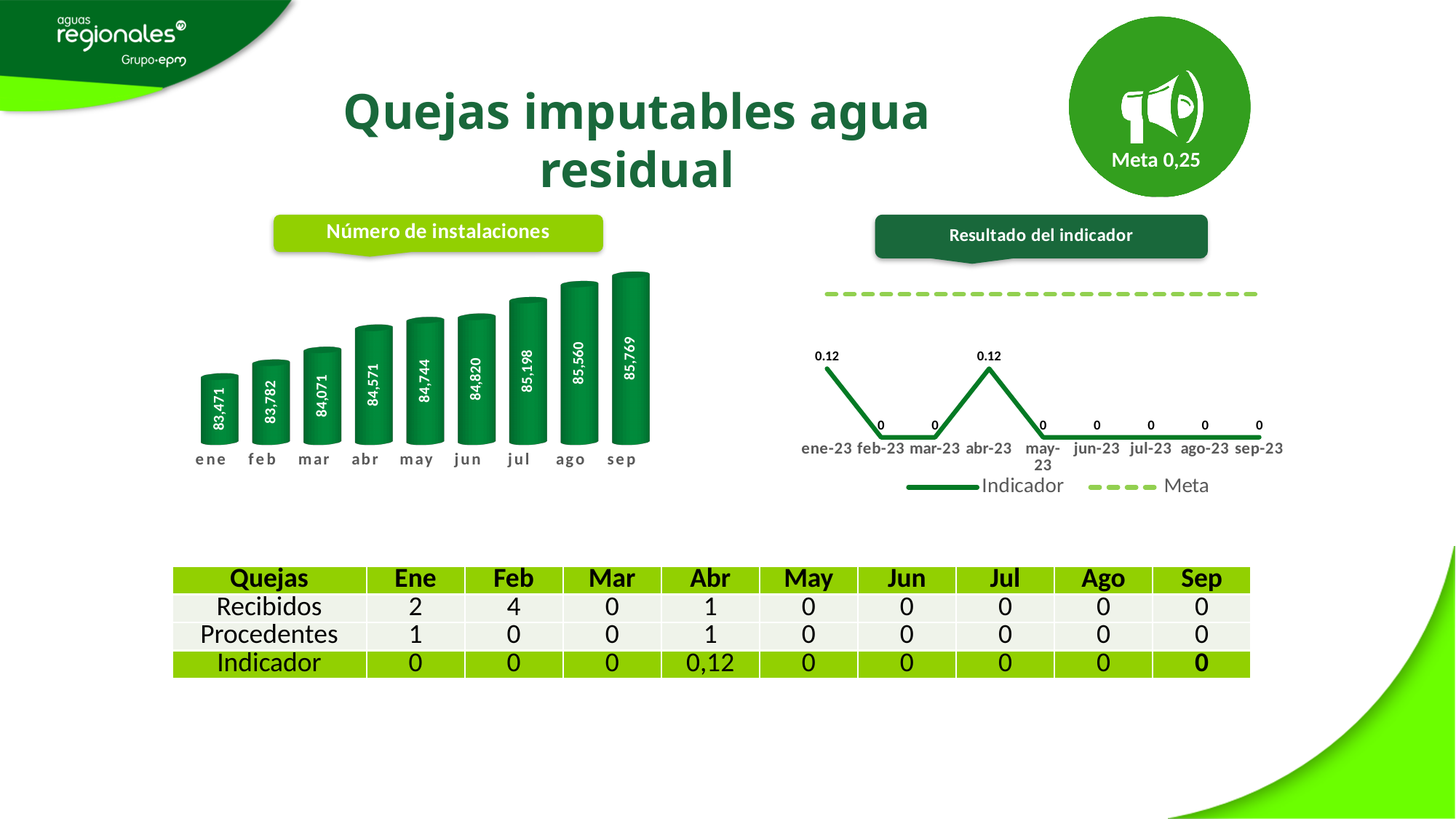
In the 'Número de instalaciones' chart, what is the value for sep? 85,769 In the 'Número de instalaciones' chart, which month has the lowest value? ene In the 'Número de instalaciones' chart, what is the value for abr? 84,571 In the 'Resultado del indicador' chart, what is the Indicador value for jun-23? 0 In the 'Número de instalaciones' chart, do the values rise or fall from ene to sep? rise What kind of chart is the 'Número de instalaciones' chart? bar chart In the 'Número de instalaciones' chart, which month has the highest value? sep In the 'Resultado del indicador' chart, how many series does the legend list? 2 What kind of chart is the 'Resultado del indicador' chart? line chart In the 'Número de instalaciones' chart, how many months are shown? 9 In the 'Resultado del indicador' chart, what is the Indicador value for abr-23? 0.12 In the 'Número de instalaciones' chart, what is the difference between the values for sep and ene? 2,298